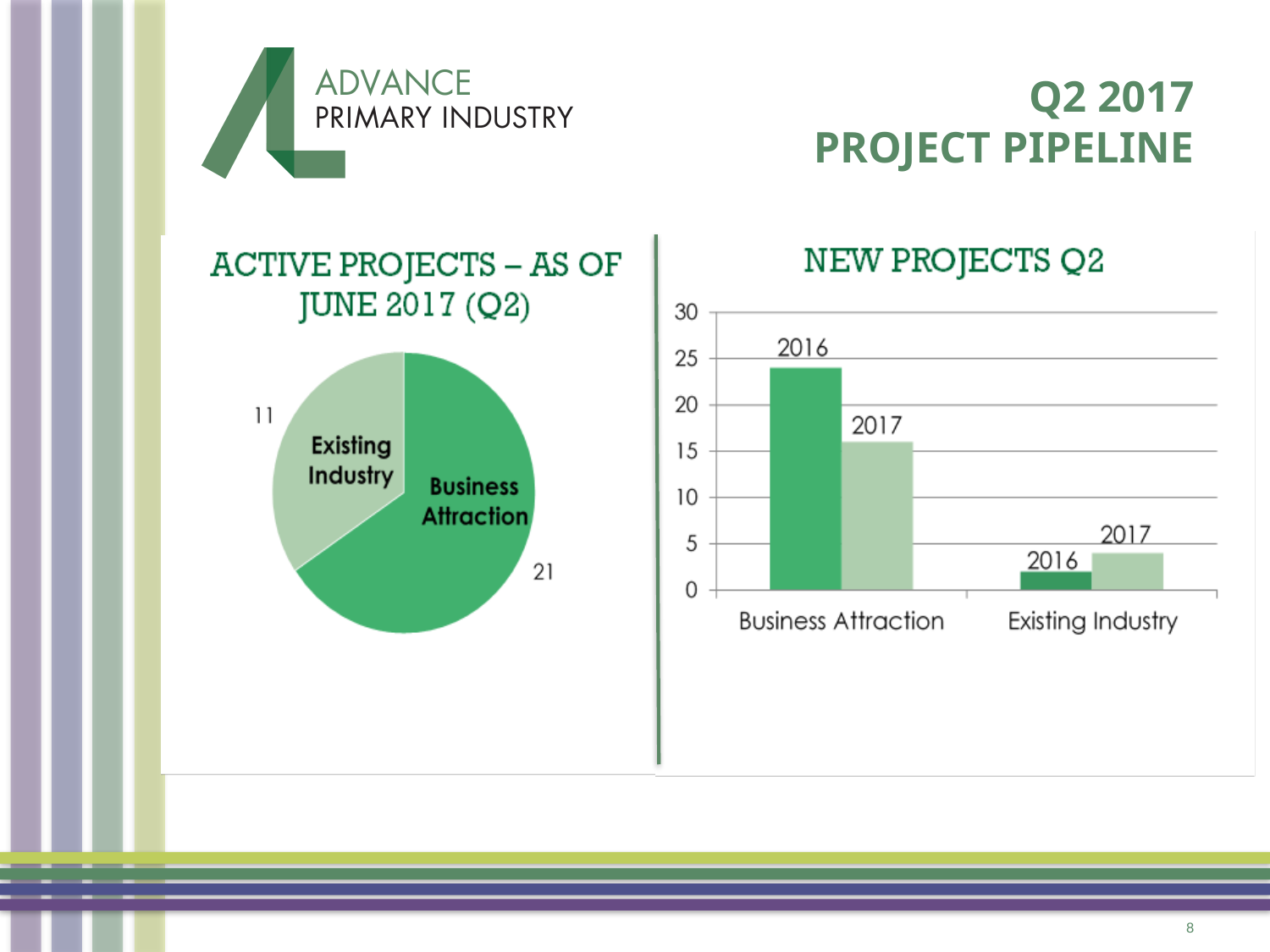
In the ACTIVE PROJECTS – AS OF JUNE 2017 (Q2) chart, how many projects are in Business Attraction? 21 What kind of chart is the ACTIVE PROJECTS – AS OF JUNE 2017 (Q2) chart? Pie chart In the NEW PROJECTS Q2 chart, how many categories are shown on the x axis? 2 In the ACTIVE PROJECTS – AS OF JUNE 2017 (Q2) chart, what is the total number of active projects across both slices? 32 What kind of chart is the NEW PROJECTS Q2 chart? Bar chart In the NEW PROJECTS Q2 chart, is the 2017 value for Existing Industry greater or less than 5? less In the ACTIVE PROJECTS – AS OF JUNE 2017 (Q2) chart, which category has the larger slice? Business Attraction In the NEW PROJECTS Q2 chart, which is larger for Business Attraction, the 2016 bar or the 2017 bar? 2016 In the NEW PROJECTS Q2 chart, which is larger for Existing Industry, the 2016 bar or the 2017 bar? 2017 In the NEW PROJECTS Q2 chart, is the 2016 value for Business Attraction greater or less than 20? greater In the ACTIVE PROJECTS – AS OF JUNE 2017 (Q2) chart, what is the difference between Business Attraction and Existing Industry? 10 In the ACTIVE PROJECTS – AS OF JUNE 2017 (Q2) chart, how many projects are in Existing Industry? 11